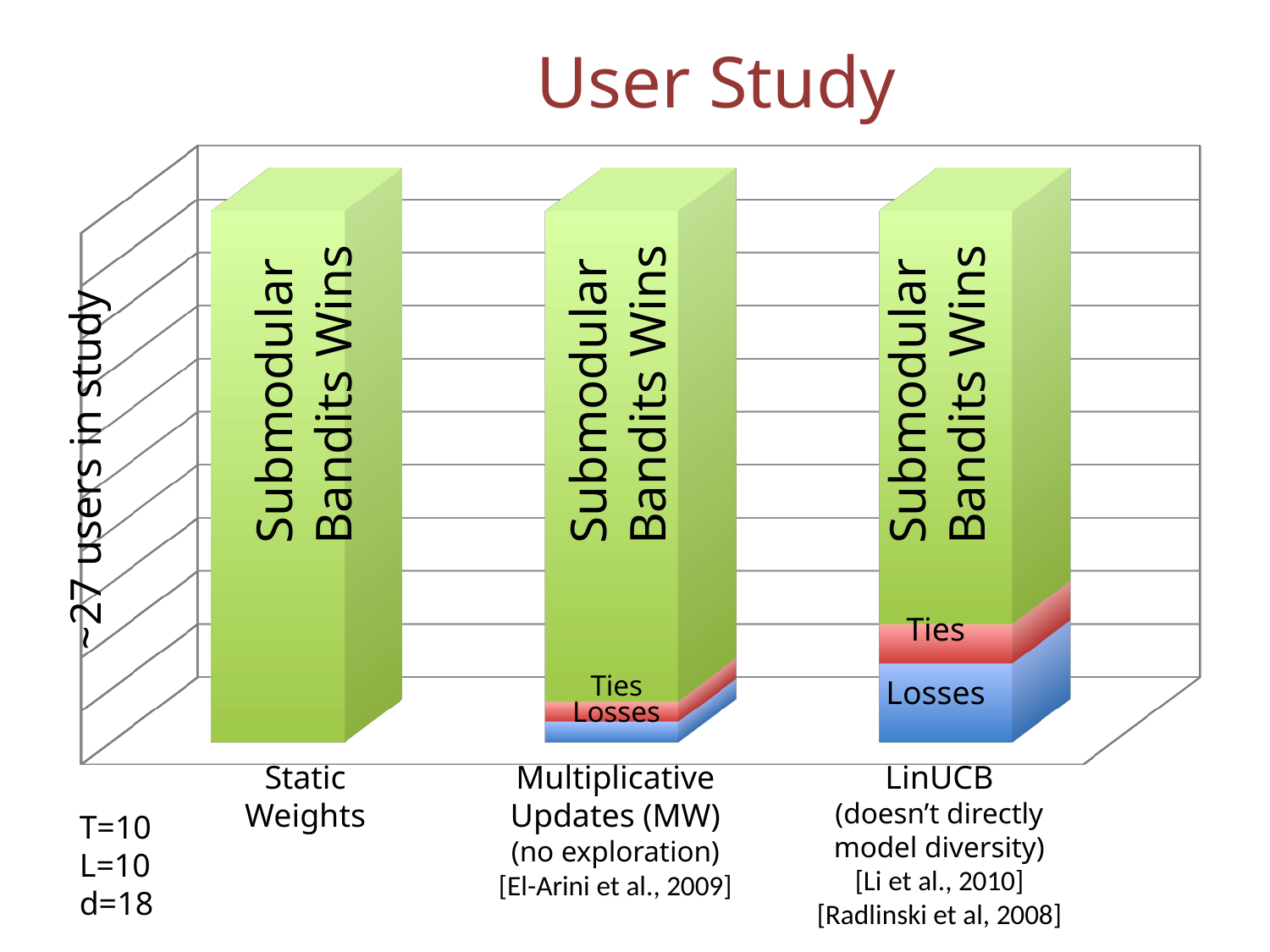
How many categories (bars) are shown on the x axis? 3 Does the Submodular Bandits Wins segment rise or fall moving left to right across the three categories? Fall What kind of chart is shown on the slide? Stacked bar chart What is the title of the slide's chart? User Study Is the Submodular Bandits Wins segment larger for Multiplicative Updates (MW) or for LinUCB? Multiplicative Updates (MW) Which category has the smallest Submodular Bandits Wins segment? LinUCB Is the Ties segment larger for LinUCB or for Multiplicative Updates (MW)? LinUCB Which category has the largest Submodular Bandits Wins segment? Static Weights Which category has the largest Losses segment? LinUCB Which category shows no Ties or Losses segments at all? Static Weights How many segments make up the LinUCB bar? 3 What is the label on the vertical axis? ~27 users in study